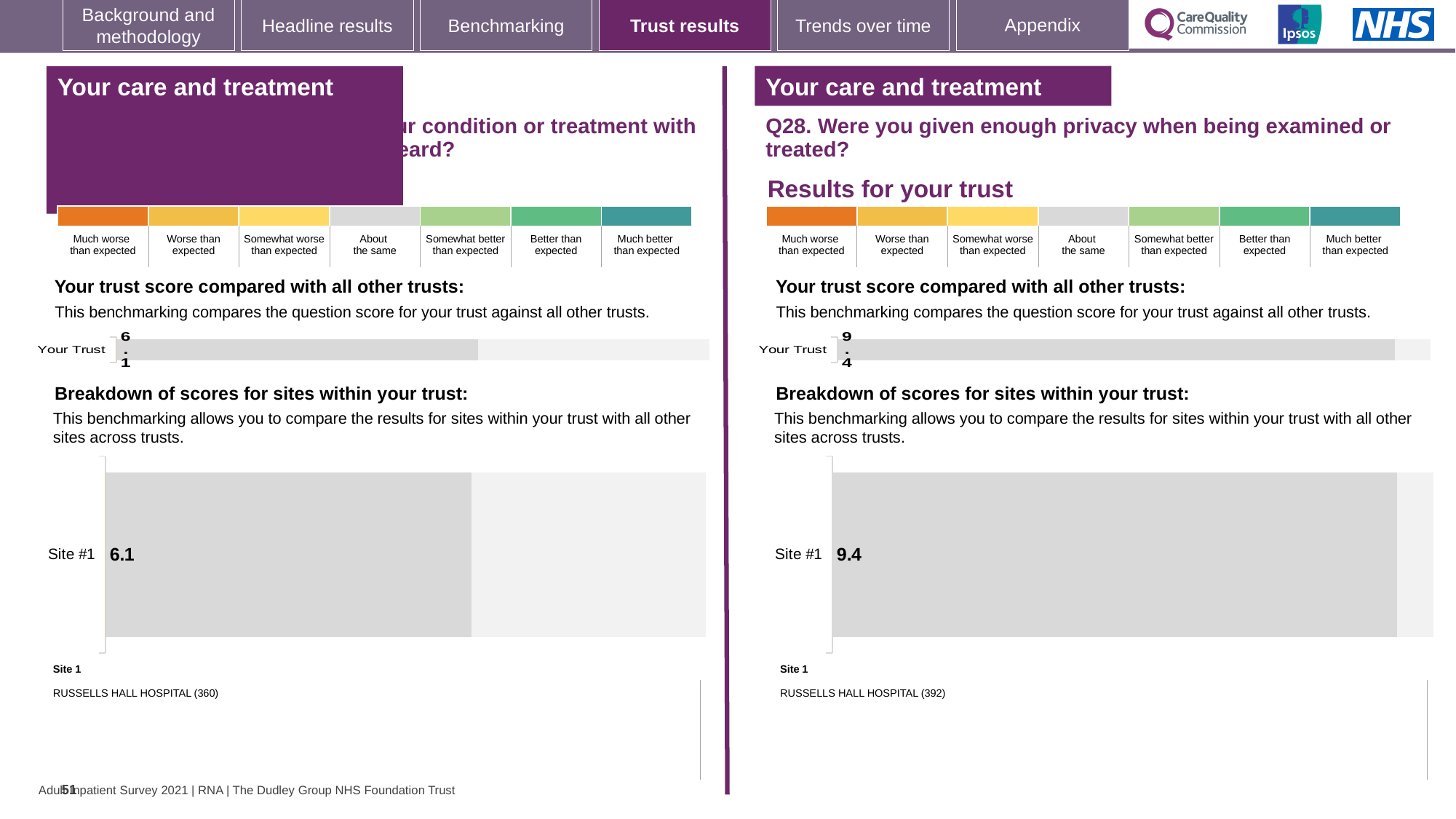
On the left half of the slide, what is the trust score shown in the 'Your trust score compared with all other trusts' chart? 6.1 On the left half of the slide, what score is shown for Site #1 in the 'Breakdown of scores for sites within your trust' chart? 6.1 On the right half of the slide (Q28, privacy when being examined or treated), what is the trust score shown in the 'Your trust score compared with all other trusts' chart? 9.4 On the right half of the slide (Q28), which site is listed as Site 1 below the chart? RUSSELLS HALL HOSPITAL (392) On the right half of the slide (Q28), what score is shown for Site #1 in the 'Breakdown of scores for sites within your trust' chart? 9.4 On the left half of the slide, which site is listed as Site 1 below the chart? RUSSELLS HALL HOSPITAL (360) Which is larger: the Site #1 score on the left half of the slide or the Site #1 score on the right half (Q28)? Right half (Q28) What type of chart is used to show the Site #1 score on the right half of the slide (Q28)? Bar chart What is the difference between the Q28 trust score on the right half of the slide and the trust score on the left half? 3.3 How many sites are shown in the 'Breakdown of scores for sites within your trust' chart on the right half of the slide (Q28)? 1 How many sites are shown in the 'Breakdown of scores for sites within your trust' chart on the left half of the slide? 1